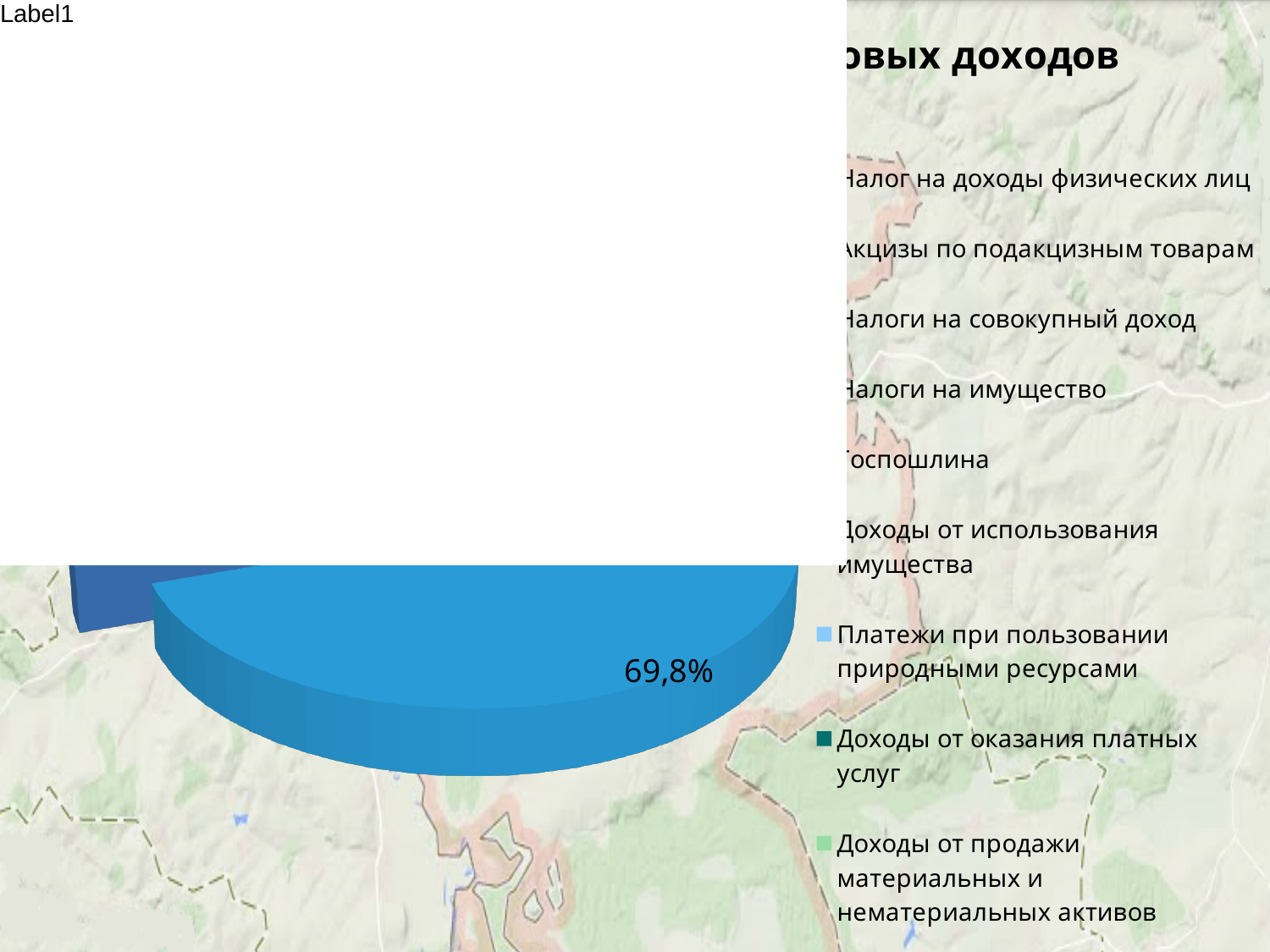
What is the first entry in the pie chart's legend? Налог на доходы физических лиц Is the share of the large blue slice greater or less than 50%? greater What percentage is printed on the large blue slice of the pie chart? 69,8% What kind of chart is shown on the slide? pie chart